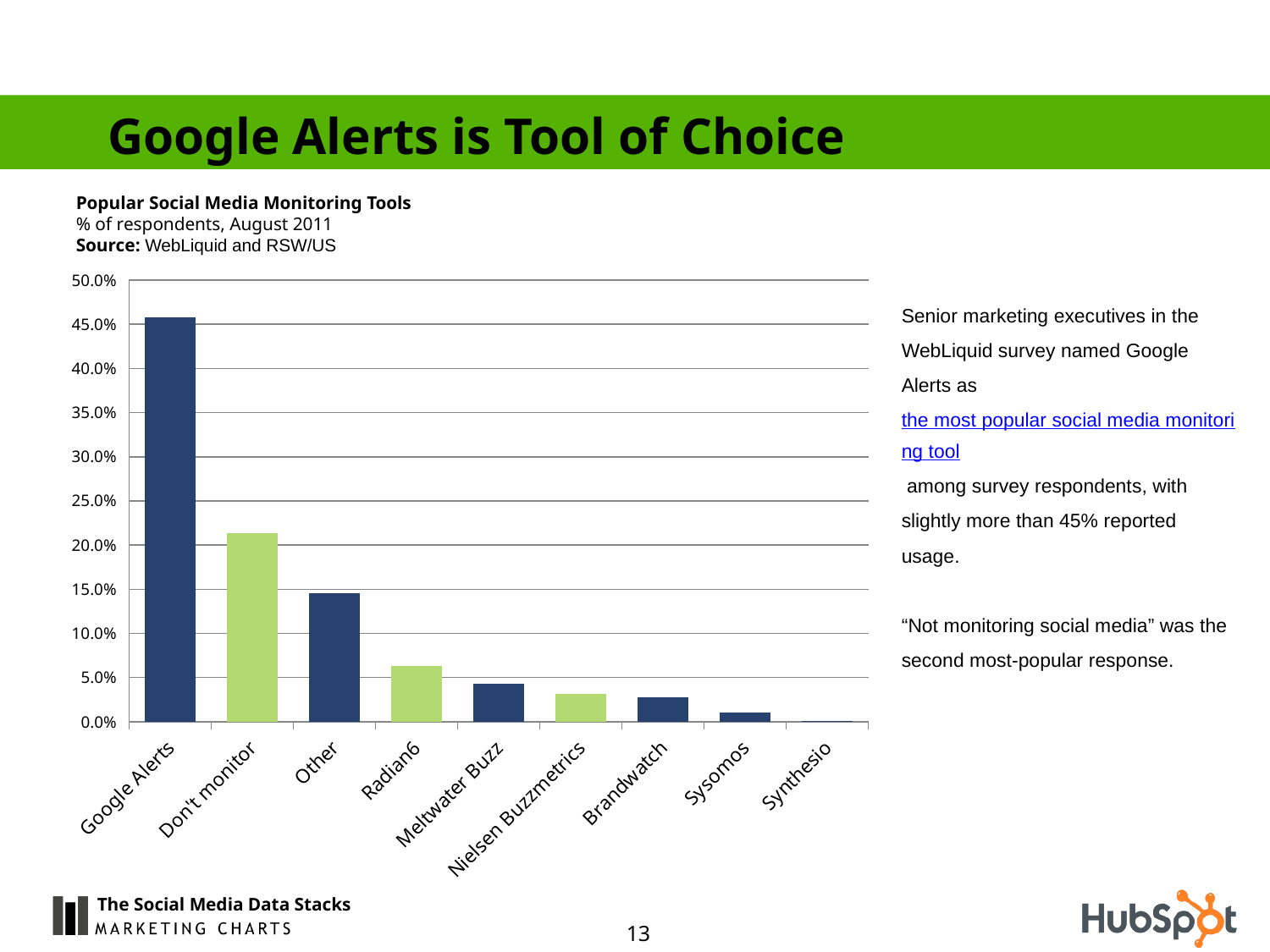
Is the value for Don't monitor greater or less than 20.0%? greater How many categories are shown on the x axis of the chart? 9 Which is larger, the value for Don't monitor or the value for Other? Don't monitor What kind of chart is shown on the slide? bar chart Do the values rise or fall moving from left to right along the x axis? fall Is the value for Radian6 greater or less than 5.0%? greater Is the value for Meltwater Buzz greater or less than 5.0%? less Which category has the highest value in the Popular Social Media Monitoring Tools chart? Google Alerts Which category has the lowest value in the Popular Social Media Monitoring Tools chart? Synthesio Which is larger, the value for Radian6 or the value for Brandwatch? Radian6